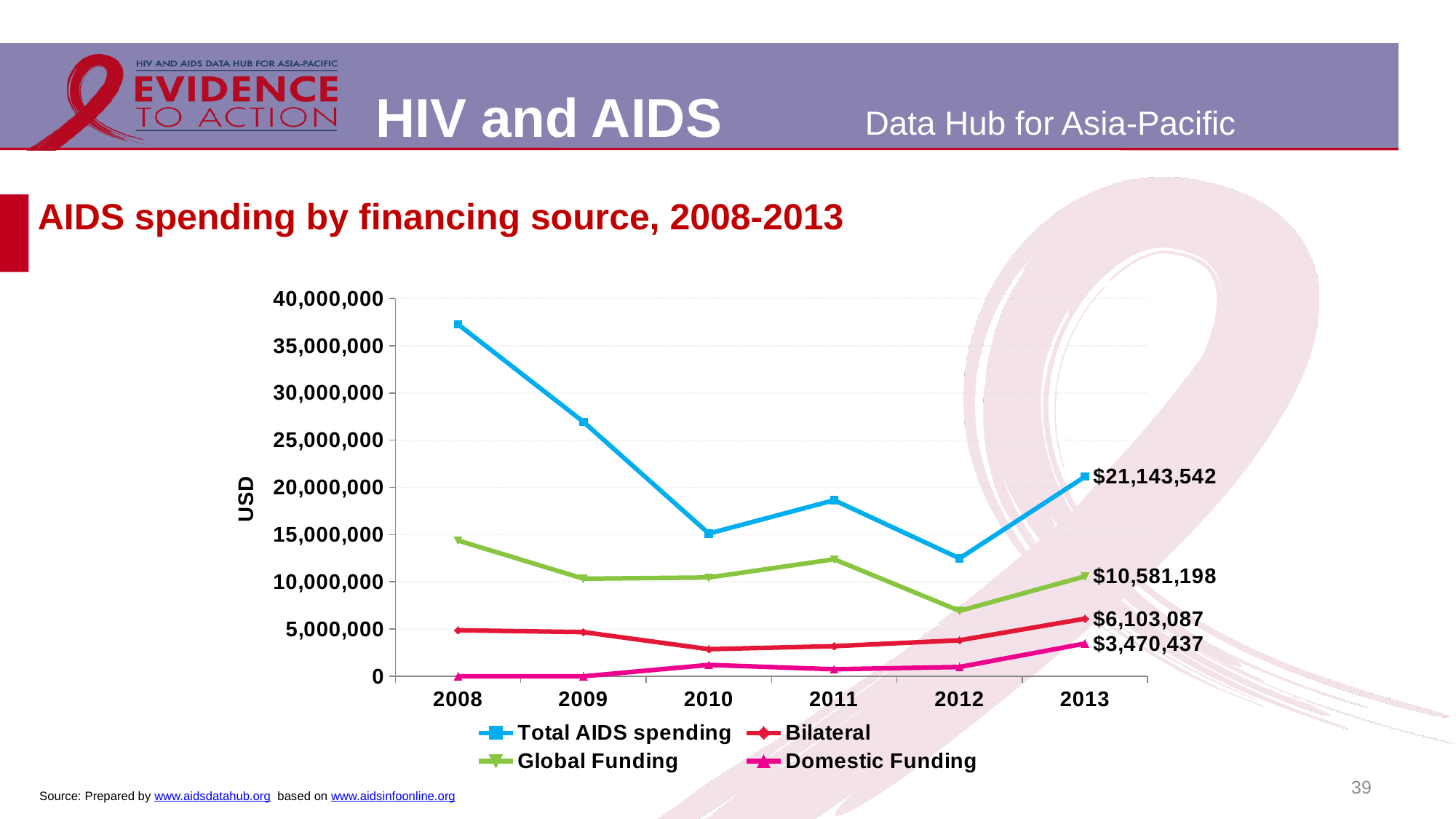
What is the value for Domestic Funding in 2013? $3,470,437 What is the value for Total AIDS spending in 2013? $21,143,542 In which year was Total AIDS spending highest? 2008 In 2013, which is larger: Global Funding or Bilateral? Global Funding What is the value for Global Funding in 2013? $10,581,198 How many series does the legend list? 4 What kind of chart is shown on the slide? Line chart Is the value for Global Funding in 2012 greater or less than 10,000,000? less What is the difference between Total AIDS spending and Global Funding in 2013? $10,562,344 Is the value for Total AIDS spending in 2008 greater or less than 35,000,000? greater What is the value for Bilateral funding in 2013? $6,103,087 In which year was Total AIDS spending lowest? 2012